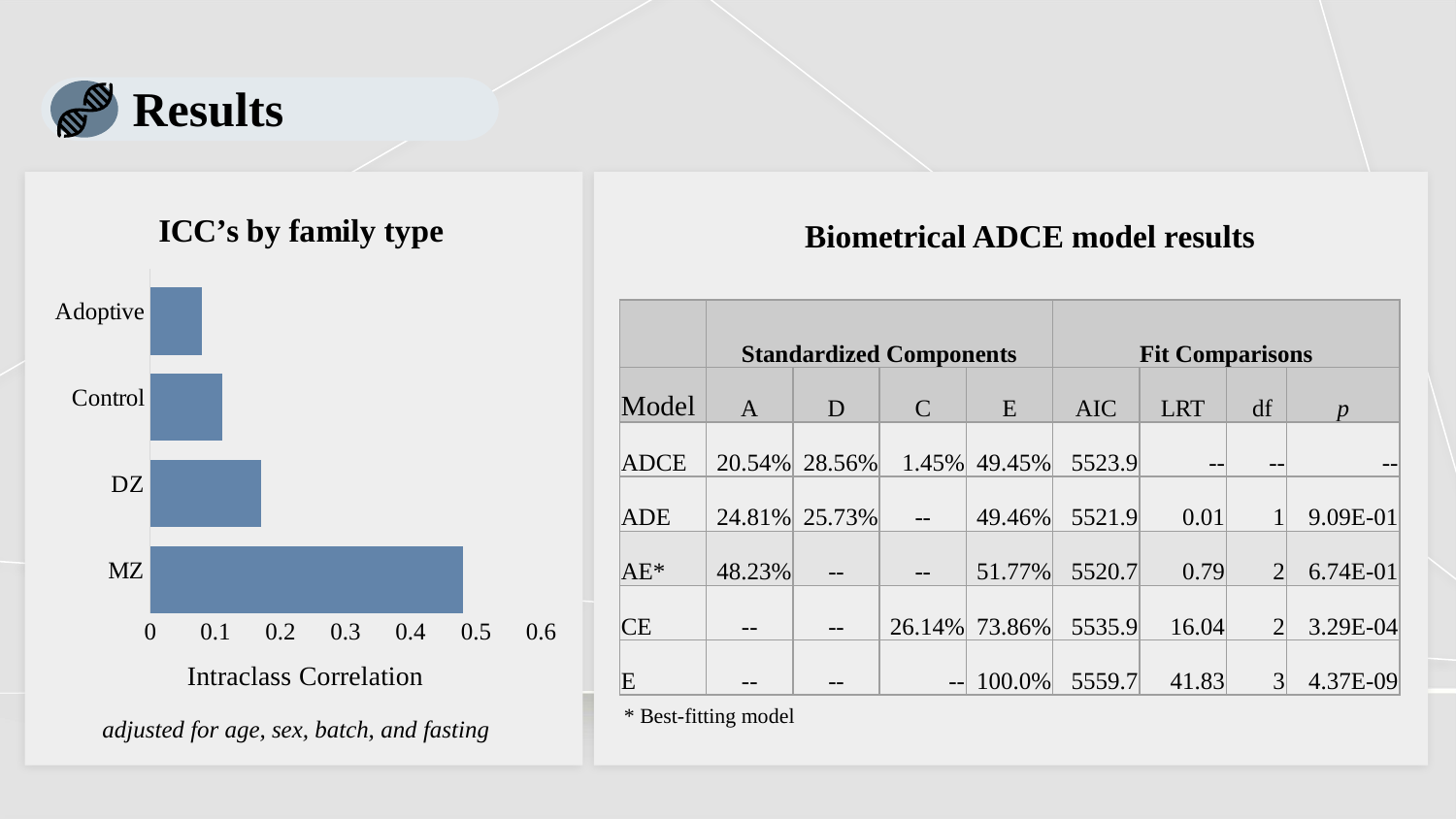
What kind of chart is "ICC's by family type"? bar chart In the "ICC's by family type" chart, is the value for Control greater or less than 0.2? less In the "ICC's by family type" chart, is the value for DZ greater or less than 0.2? less In the "ICC's by family type" chart, which has a larger intraclass correlation, DZ or Control? DZ What is the highest tick value shown on the x axis of the "ICC's by family type" chart? 0.6 How many family types are shown in the "ICC's by family type" chart? 4 In the "ICC's by family type" chart, is the value for MZ greater or less than 0.4? greater In the "ICC's by family type" chart, which family type has the highest intraclass correlation? MZ In the "ICC's by family type" chart, which family type has the lowest intraclass correlation? Adoptive What is the x-axis label of the "ICC's by family type" chart? Intraclass Correlation In the "ICC's by family type" chart, which has a larger intraclass correlation, MZ or DZ? MZ